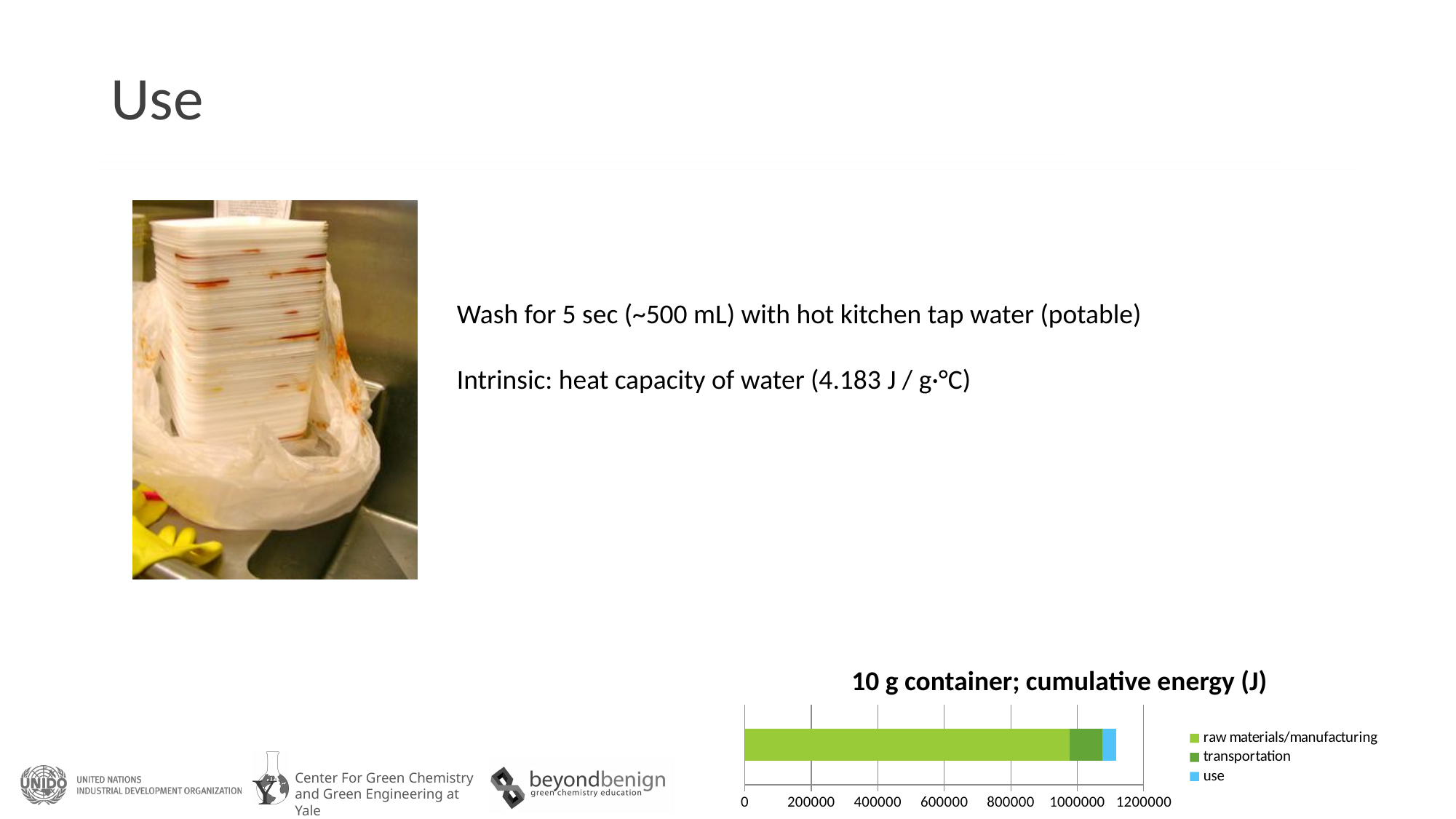
Which series in the chart accounts for the smallest share of the cumulative energy? use Which series in the chart accounts for the largest share of the cumulative energy? raw materials/manufacturing Is the value for raw materials/manufacturing greater or less than 800000? greater Which series is larger in the chart, raw materials/manufacturing or transportation? raw materials/manufacturing Is the total length of the stacked bar greater or less than 1200000? less What is the title of the chart? 10 g container; cumulative energy (J) What colour represents the use series in the chart's legend? blue How many bars are plotted in the chart? 1 Which series is larger in the chart, transportation or use? transportation What kind of chart is shown on the slide? stacked bar chart How many series does the legend of the chart list? 3 Is the total length of the stacked bar greater or less than 1000000? greater